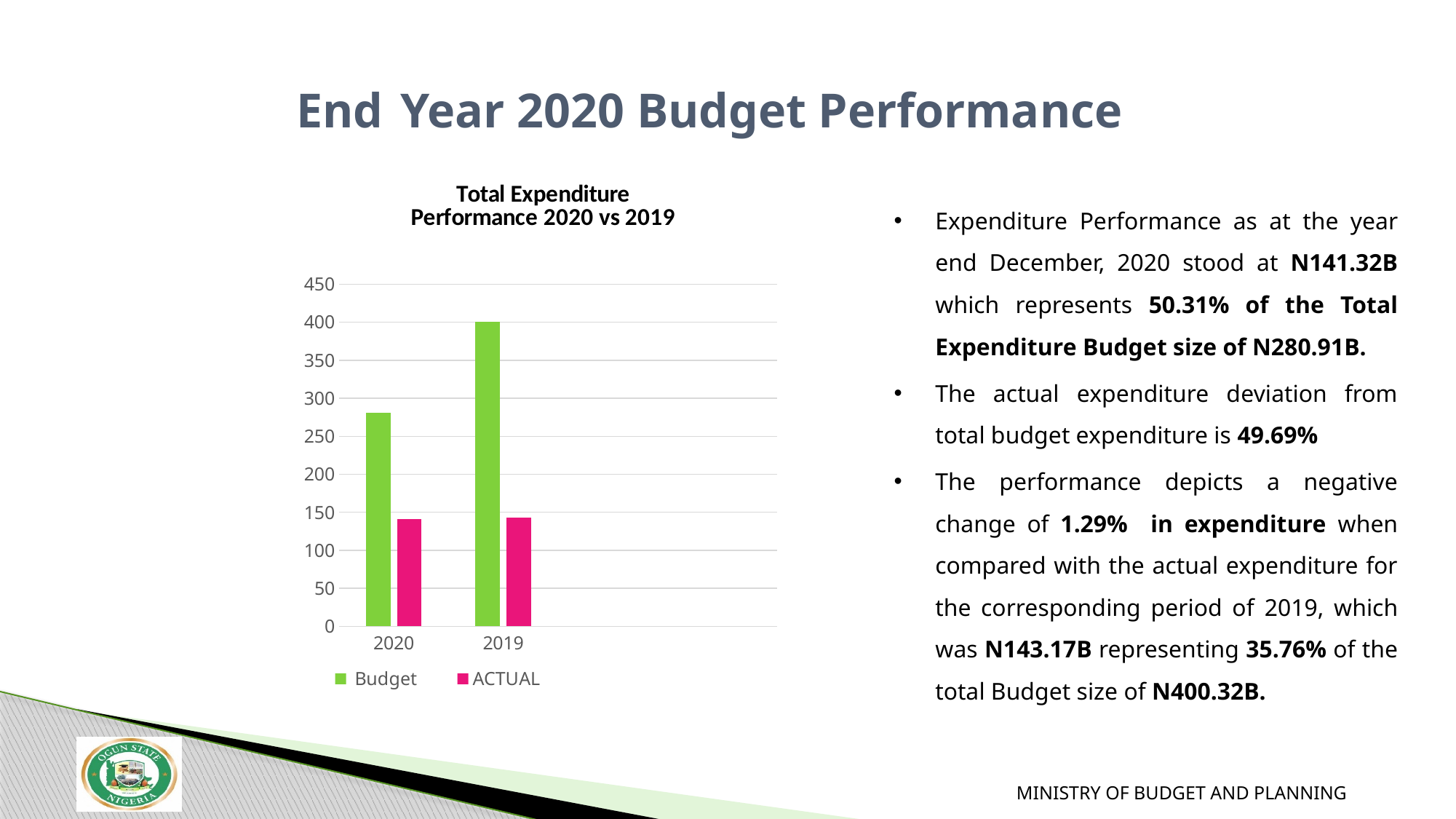
What kind of chart is shown on the slide? bar chart What is the title of the chart? Total Expenditure Performance 2020 vs 2019 In 2020, which is larger, the Budget bar or the ACTUAL bar? Budget What are the two series listed in the chart legend? Budget and ACTUAL Is the Budget value for 2019 greater or less than 350? greater Which year has the higher Budget bar in the chart? 2019 Is the ACTUAL value for 2020 greater or less than 200? less Which year has the lower Budget bar in the chart? 2020 How many year categories are shown on the x axis of the chart? 2 Is the Budget value for 2020 greater or less than 250? greater How many series does the chart legend list? 2